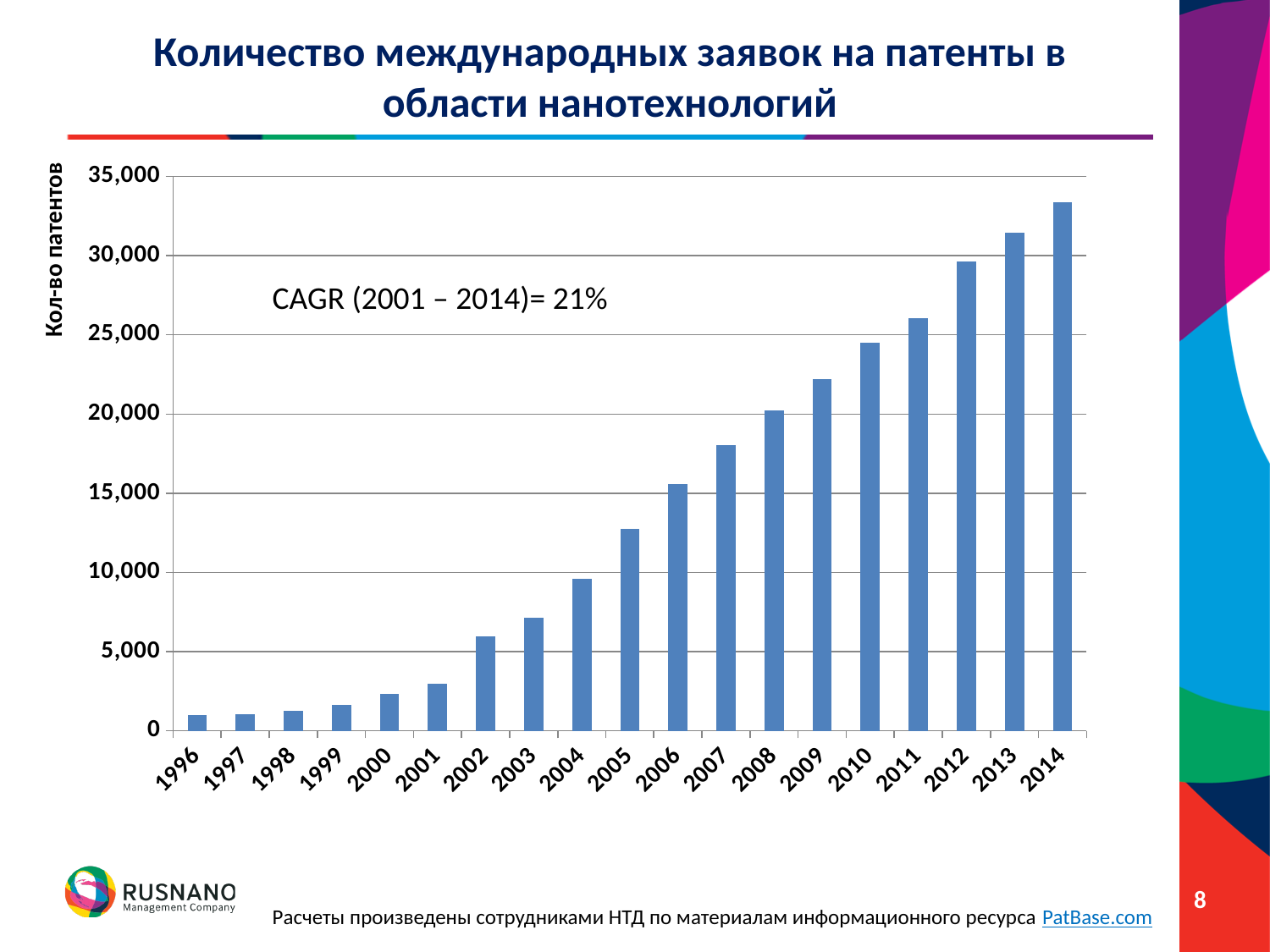
Is the value for 2005 greater or less than 10,000? greater Is the value for 2001 greater or less than 5,000? less What is the label of the vertical axis? Кол-во патентов Is the value for 2011 greater or less than 25,000? greater Which year has the highest number of international nanotechnology patent applications? 2014 What CAGR for 2001–2014 is stated on the chart? 21% What kind of chart is shown on the slide? bar chart Which year has the larger value, 2010 or 2005? 2010 How many years are shown on the x axis of the chart? 19 Do the values rise or fall from 1996 to 2014? rise